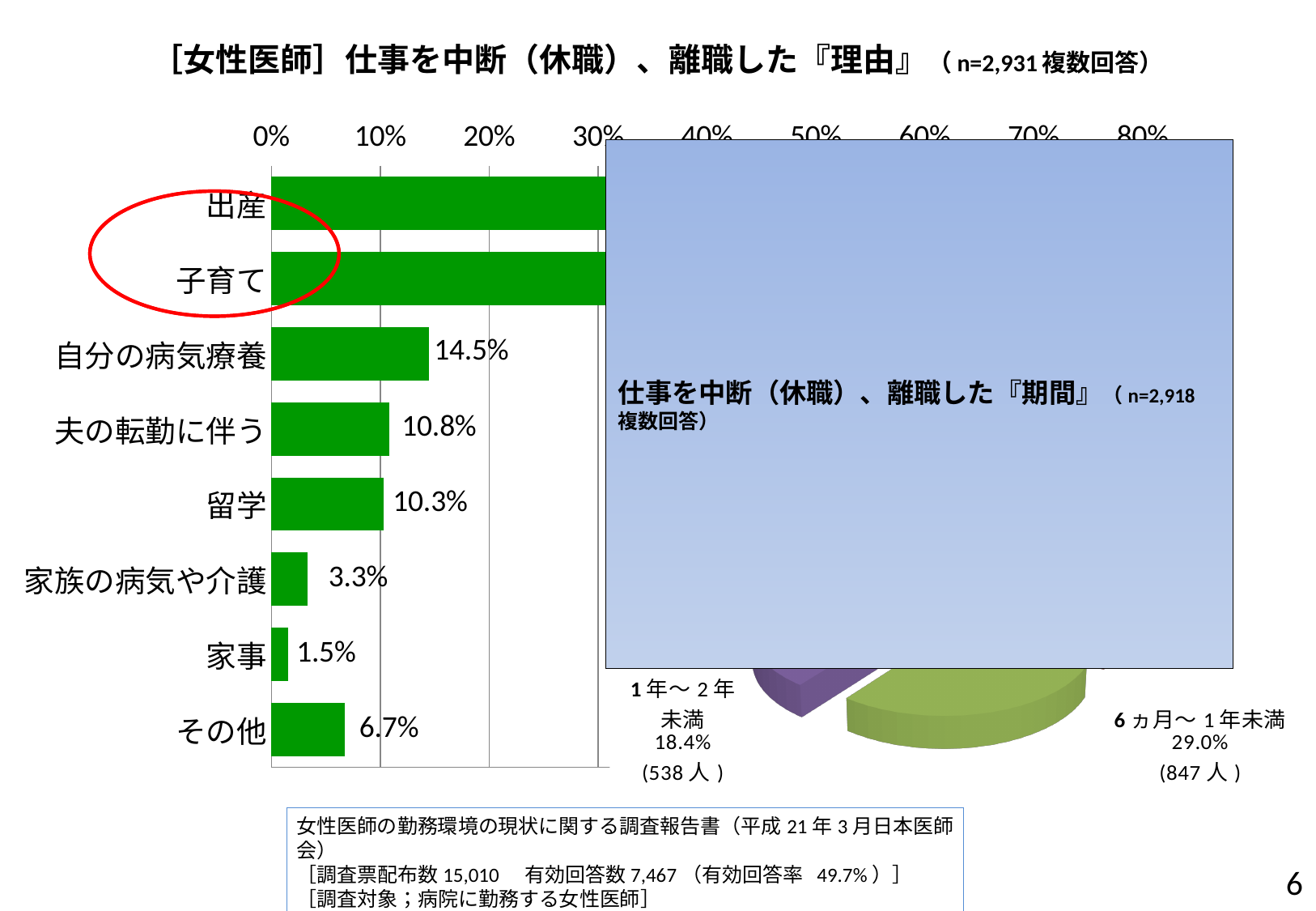
In the pie chart, what is the value for 1年～2年未満? 18.4% In the pie chart, what share does 6ヵ月～1年未満 have? 29.0% How many categories does the bar chart show? 8 In the bar chart, what is the value for その他? 6.7% In the bar chart, what is the value for 自分の病気療養? 14.5% In the bar chart, what is the difference between 自分の病気療養 and 夫の転勤に伴う? 3.7% In the bar chart, which category has the lowest value? 家事 In the bar chart, what is the value for 家族の病気や介護? 3.3% What kind of chart is the chart on the left of the slide? bar chart In the bar chart, what is the value for 夫の転勤に伴う? 10.8% In the bar chart, is the value for 出産 greater or less than 20%? greater In the bar chart, which is larger, 夫の転勤に伴う or 留学? 夫の転勤に伴う